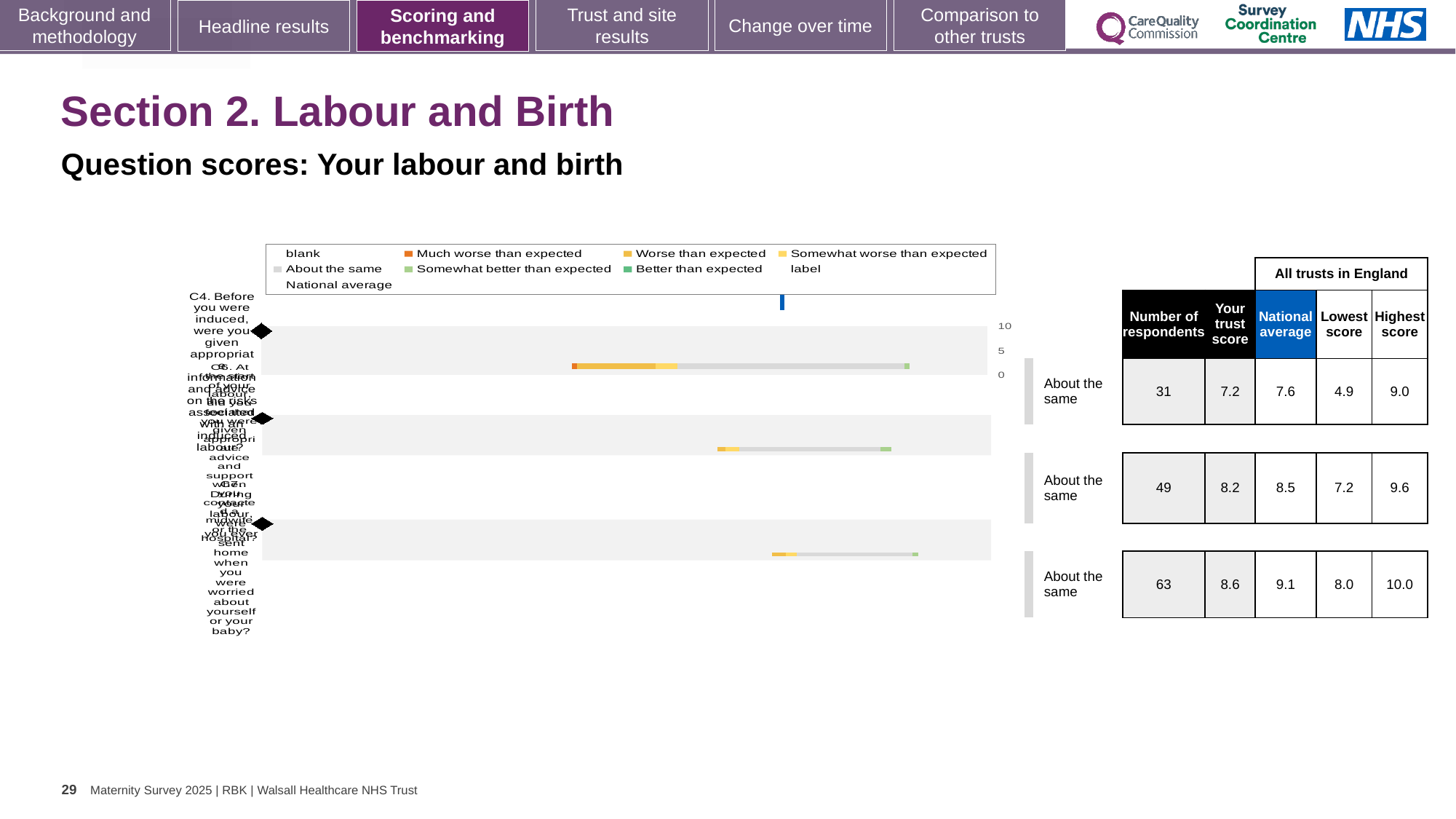
In the table beside the chart, what is the Highest score for the row with 63 respondents? 10.0 In the table beside the chart, what is the difference between the National average and 'Your trust score' for the first row (31 respondents)? 0.4 What kind of chart is shown on the slide? bar chart In the chart legend, what does the blue vertical marker represent? National average In the table beside the chart, for the row with 63 respondents, which is larger: 'Your trust score' or the National average? National average How many question rows are plotted in the chart? 3 In the table beside the chart, which row has the highest 'Your trust score'? the third row (63 respondents), 8.6 In the table beside the chart, what is the Lowest score for the row with 31 respondents? 4.9 In the chart legend, what colour represents 'Much worse than expected'? orange In the table beside the chart, what is 'Your trust score' for the first row (31 respondents)? 7.2 In the table beside the chart, what is the National average for the row with 49 respondents? 8.5 What benchmark rating is shown next to each of the three question rows? About the same